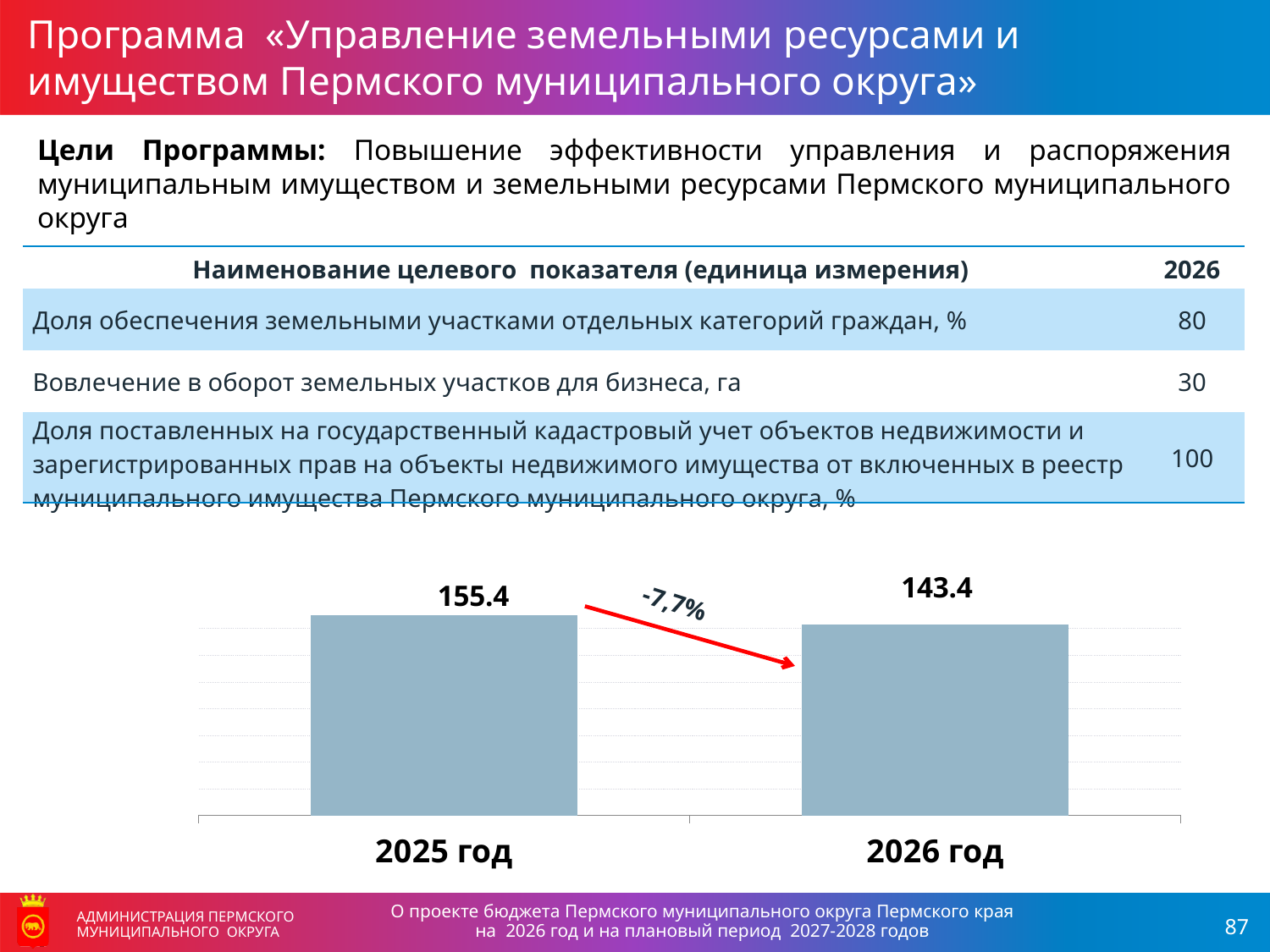
What are the two category labels on the x axis of the chart? 2025 год and 2026 год What is the value shown for 2026 год? 143.4 What percentage change is written on the arrow between the two bars? -7,7% Which year has the higher value in the chart? 2025 год Which year has the lower value in the chart? 2026 год What kind of chart is shown on the slide? bar chart Do the values rise or fall from 2025 год to 2026 год? fall Is the value for 2026 год larger or smaller than the value for 2025 год? smaller How many bars are plotted in the chart? 2 What is the value shown for 2025 год? 155.4 What is the difference between the values for 2025 год and 2026 год? 12.0